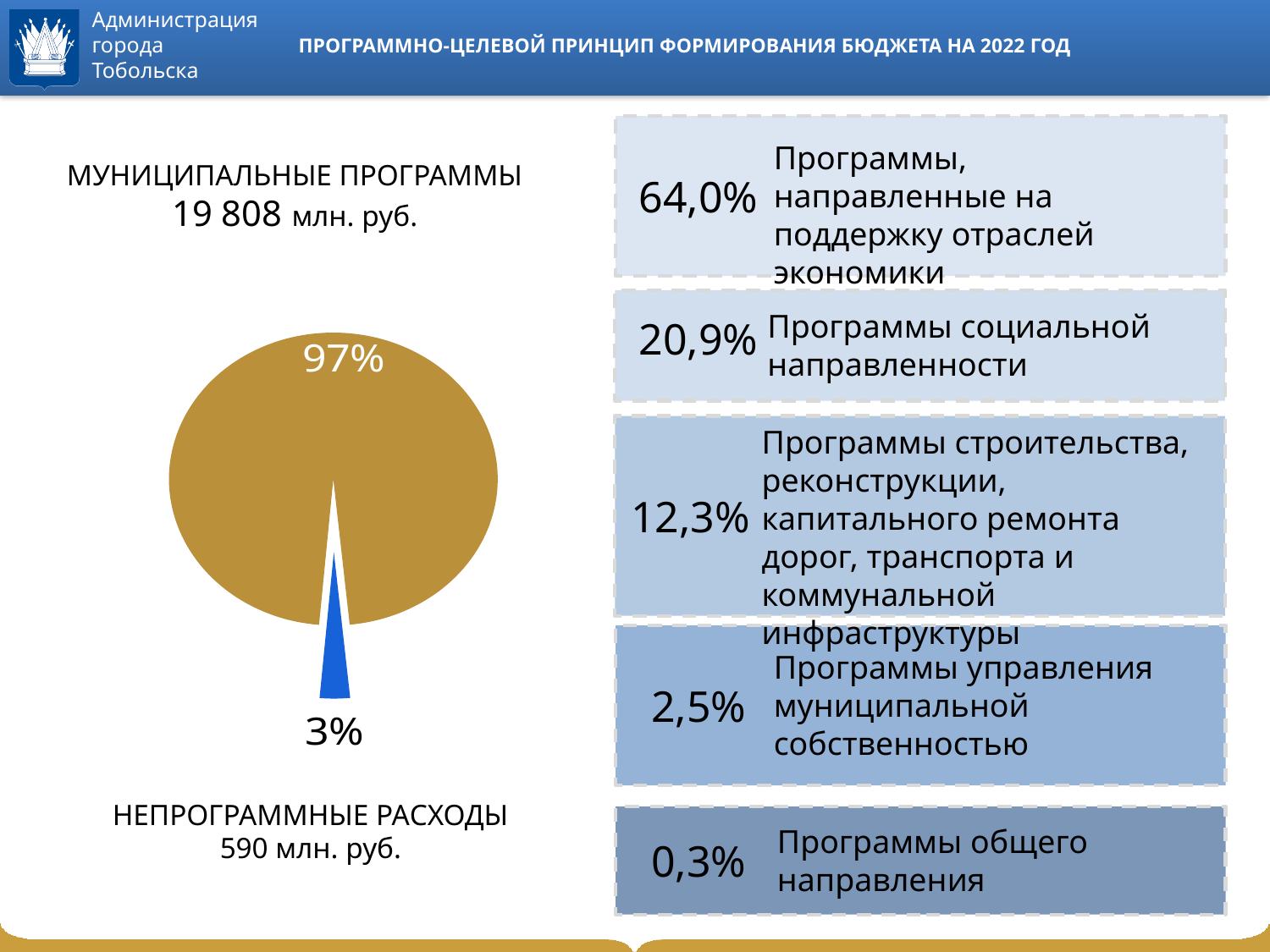
What amount in млн. руб. is shown for НЕПРОГРАММНЫЕ РАСХОДЫ below the pie chart? 590 млн. руб. Which slice of the pie chart is the smallest? НЕПРОГРАММНЫЕ РАСХОДЫ (3%) Which slice of the pie chart is the largest? МУНИЦИПАЛЬНЫЕ ПРОГРАММЫ (97%) What share of the pie chart is labelled 97%? МУНИЦИПАЛЬНЫЕ ПРОГРАММЫ What colour is the 3% slice of the pie chart? blue What is the difference in percentage points between the two slices of the pie chart? 94 What amount in млн. руб. is shown for МУНИЦИПАЛЬНЫЕ ПРОГРАММЫ above the pie chart? 19 808 млн. руб. What kind of chart is shown on the left of the slide? pie chart What share of the pie chart do МУНИЦИПАЛЬНЫЕ ПРОГРАММЫ take? 97% How many slices does the pie chart have? 2 Which is larger in the pie chart: МУНИЦИПАЛЬНЫЕ ПРОГРАММЫ or НЕПРОГРАММНЫЕ РАСХОДЫ? МУНИЦИПАЛЬНЫЕ ПРОГРАММЫ What share of the pie chart do НЕПРОГРАММНЫЕ РАСХОДЫ take? 3%